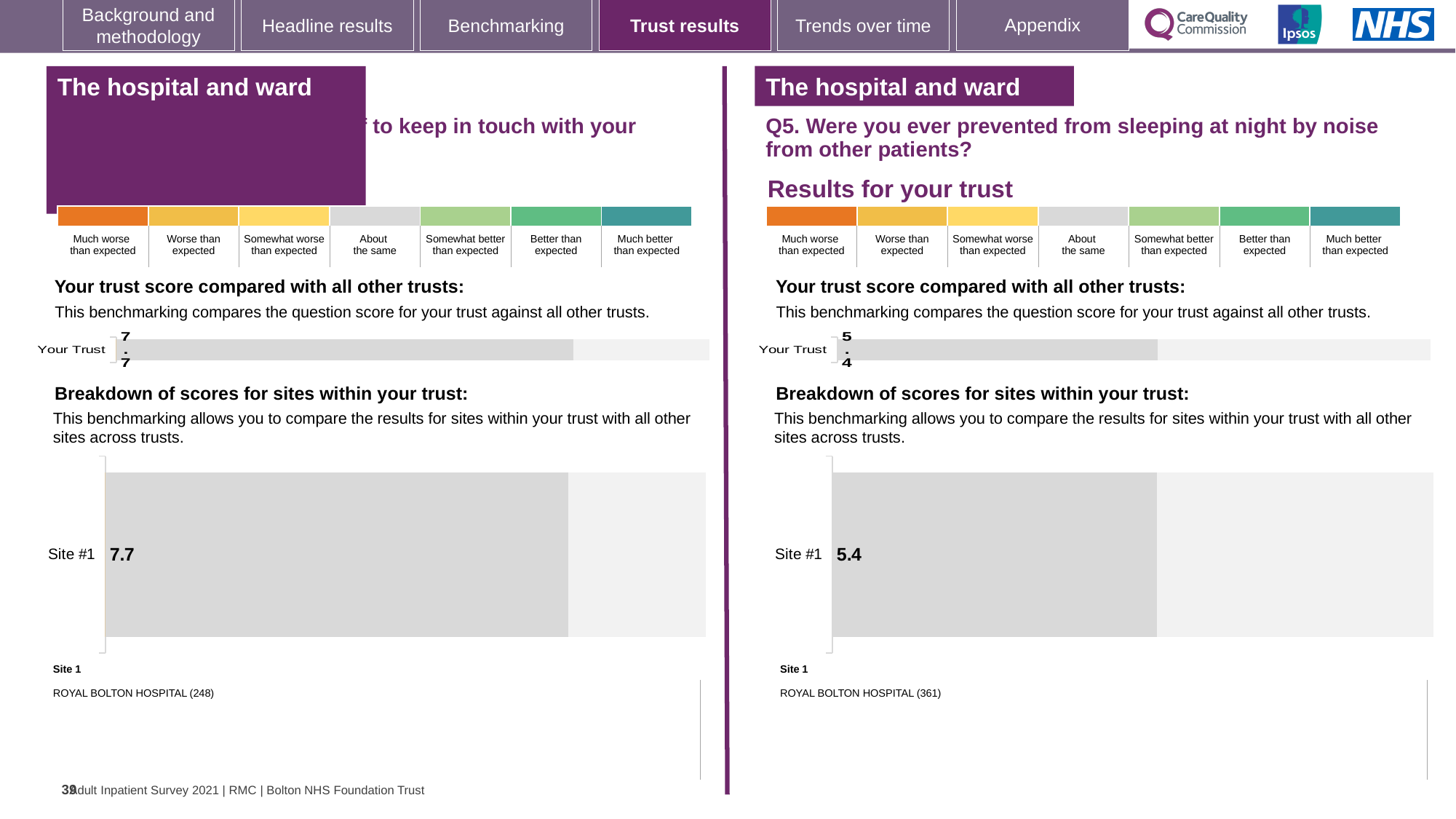
What type of chart is used to show the Site #1 score on the right-hand Q5 section? Bar chart On the left-hand chart (breakdown of scores for sites within your trust), what is the score shown for Site #1? 7.7 On the left-hand section, which hospital is listed as Site 1? ROYAL BOLTON HOSPITAL (248) How many sites are shown in the right-hand 'Breakdown of scores for sites within your trust' chart for Q5? 1 How many sites are shown in the left-hand 'Breakdown of scores for sites within your trust' chart? 1 On the right-hand 'Your trust score compared with all other trusts' chart for Q5, what is the value shown for Your Trust? 5.4 On the right-hand chart for Q5 (prevented from sleeping at night by noise from other patients), what is the score shown for Site #1? 5.4 What is the difference between the Site #1 score on the left-hand chart and the Site #1 score on the right-hand Q5 chart? 2.3 On the right-hand Q5 section, which hospital is listed as Site 1? ROYAL BOLTON HOSPITAL (361) Which Site #1 score is larger: the one on the left-hand chart or the one on the right-hand Q5 chart? The left-hand chart (7.7) On the left-hand 'Your trust score compared with all other trusts' chart, what is the value shown for Your Trust? 7.7